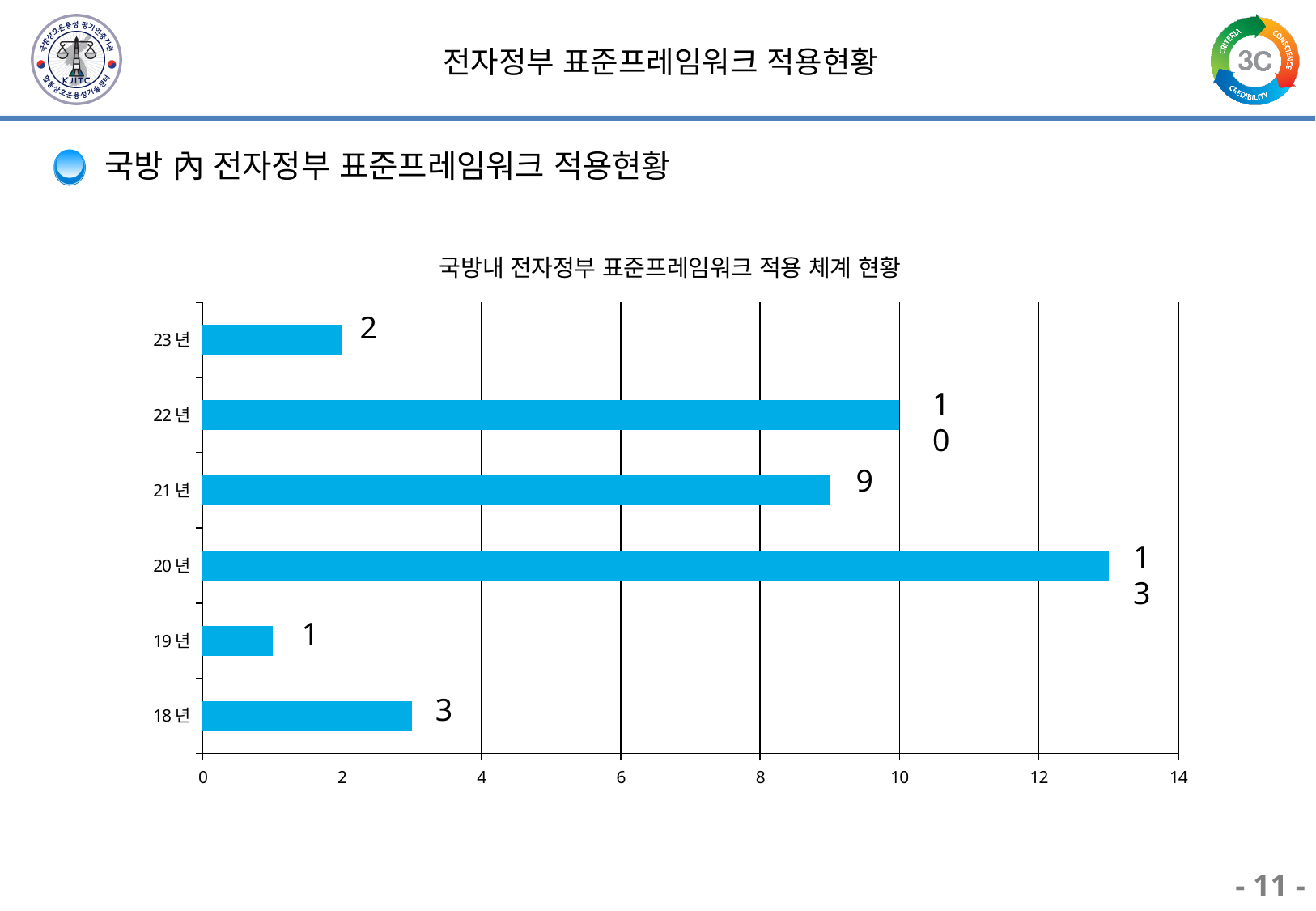
Which year has the lowest value? 19년 How many years are shown on the chart? 6 What is the value for 23년? 2 What is the difference between the values for 20년 and 22년? 3 What is the title of the chart? 국방내 전자정부 표준프레임워크 적용 체계 현황 What is the value for 22년? 10 What is the value for 21년? 9 What is the value for 19년? 1 Which is larger, the value for 18년 or the value for 23년? 18년 What is the value for 20년? 13 What kind of chart is shown on the slide? Bar chart Which year has the highest value? 20년